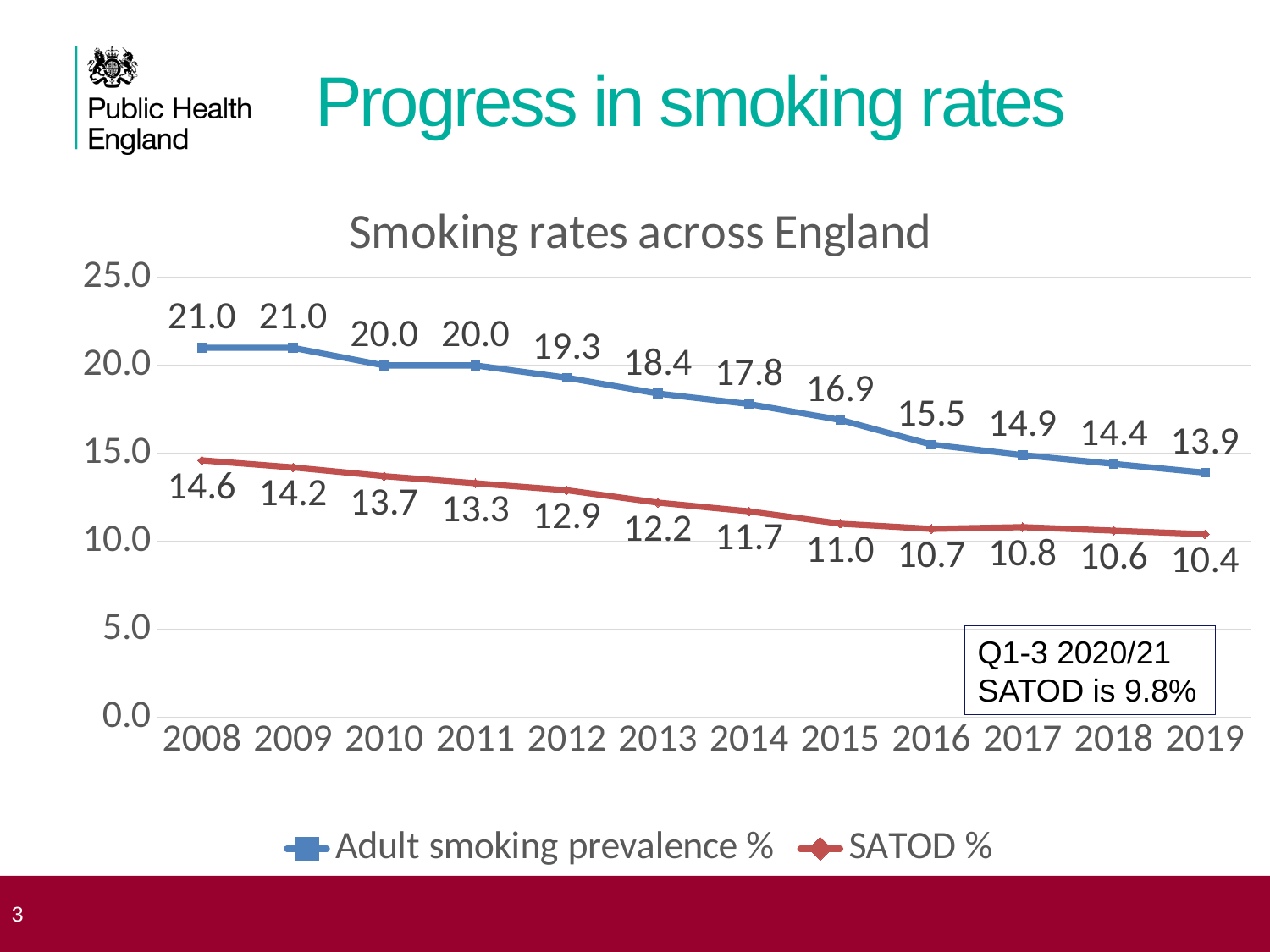
In which year is the adult smoking prevalence % lowest? 2019 What is the difference between adult smoking prevalence % in 2008 and 2019? 7.1 What is the title of the chart? Smoking rates across England How many series does the legend list? 2 What is the SATOD % value for 2016? 10.7 What is the adult smoking prevalence % in 2013? 18.4 In which year is the SATOD % highest? 2008 How many years are shown on the x axis? 12 Is the SATOD % value for 2019 greater or less than 15.0? less What kind of chart is shown on the slide? Line chart Which is larger in 2012: adult smoking prevalence % or SATOD %? Adult smoking prevalence % What is the difference between adult smoking prevalence % and SATOD % in 2015? 5.9